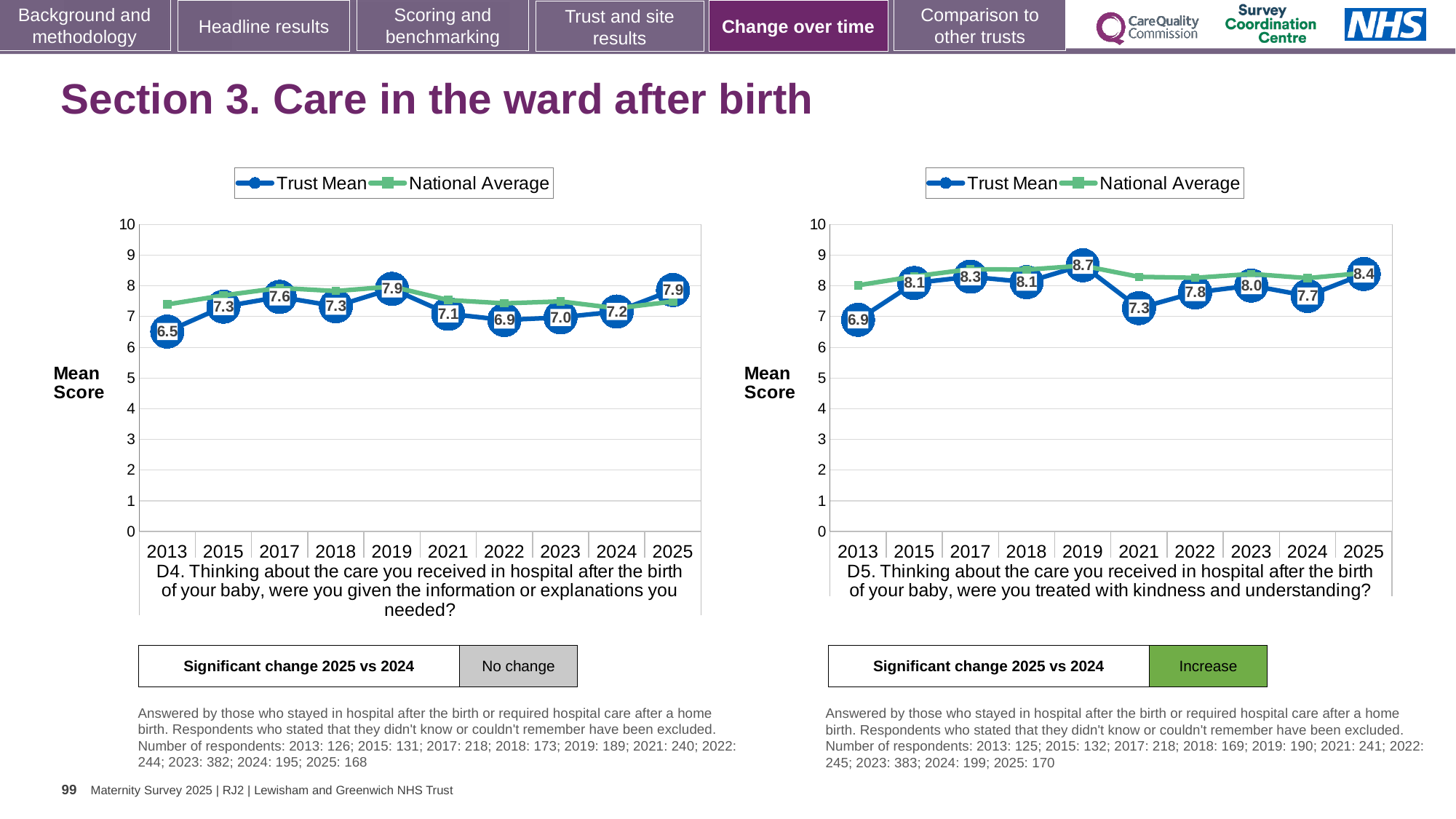
In the D4 chart (left), which year has the lowest Trust Mean score? 2013 In the D4 chart (left), which is larger, the Trust Mean for 2017 or for 2021? 2017 In the D5 chart (right), what is the difference between the Trust Mean scores for 2025 and 2024? 0.7 How many series does the legend of the D5 chart (right) list? 2 In the D4 chart (left), what is the Trust Mean score for 2025? 7.9 In the D5 chart (right), is the National Average for 2013 greater or less than 7? greater In the D5 chart (right), which year has the highest Trust Mean score? 2019 In the D5 chart (right), what is the Trust Mean score for 2019? 8.7 In the D4 chart (left), what is the Trust Mean score for 2013? 6.5 In the D4 chart (left), what is the difference between the Trust Mean scores for 2019 and 2022? 1.0 In the D5 chart (right), what is the Trust Mean score for 2021? 7.3 How many years are plotted on the x axis of the D4 chart (left)? 10